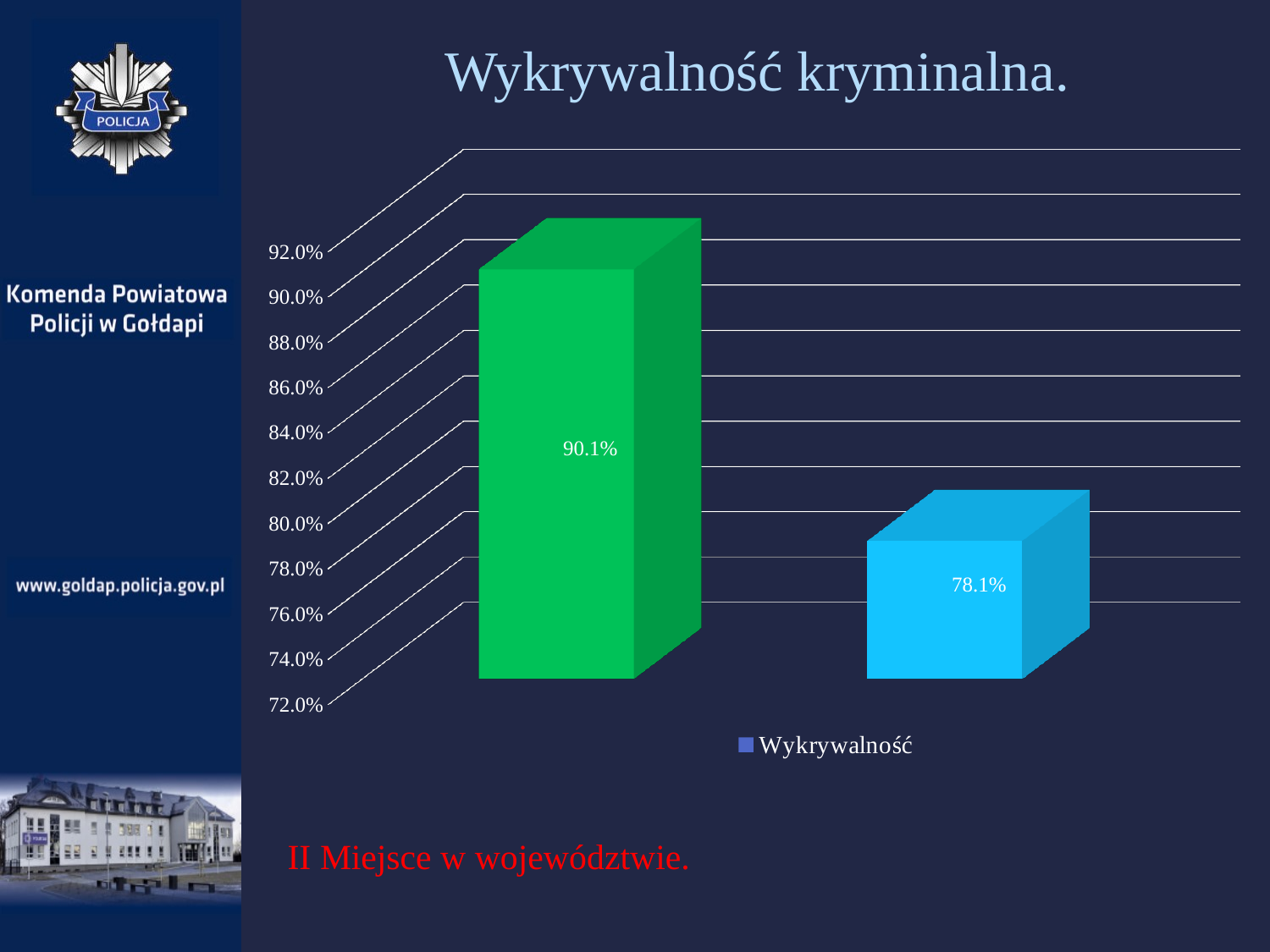
Is the value of the green bar greater or less than 88.0%? greater What value is shown on the blue bar in the chart? 78.1% What value is shown on the green bar in the chart? 90.1% What is the difference between the value of the green bar and the value of the blue bar? 12.0% Is the value of the blue bar greater or less than 80.0%? less How many bars are plotted in the chart? 2 Which bar has the highest value, the green (left) bar or the blue (right) bar? the green (left) bar How many series does the legend list? 1 What kind of chart is shown on the slide? bar chart Is the value of the left bar larger or smaller than the value of the right bar? larger What is the title of the chart? Wykrywalność kryminalna. Which bar has the lowest value, the green (left) bar or the blue (right) bar? the blue (right) bar